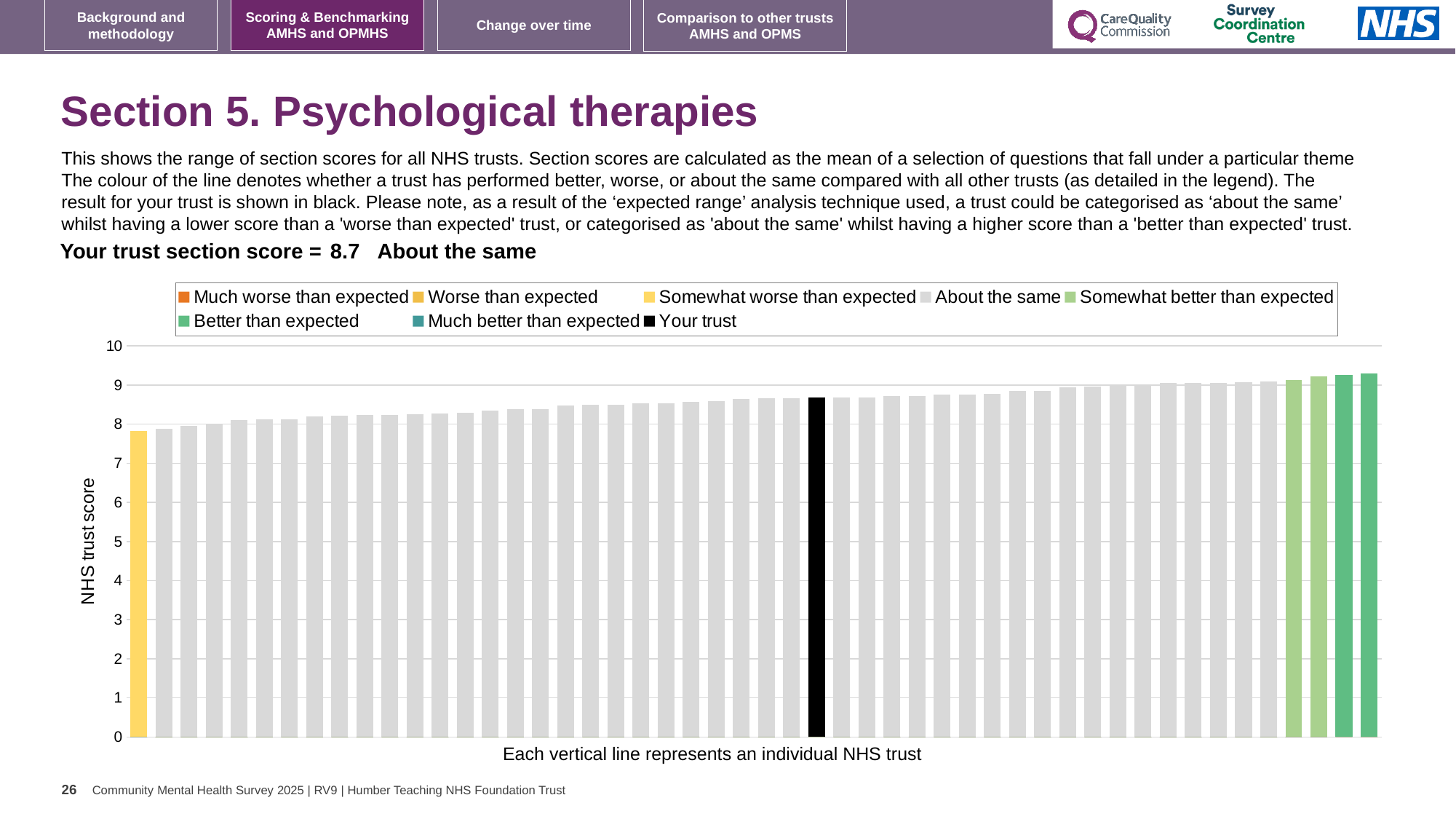
Do the bar values rise or fall from left to right across the chart? rise Is the value of the highest bar (the rightmost, green bar) greater or less than 9? greater Is the value of the lowest bar (the leftmost, yellow bar) greater or less than 8? less What colour is the bar representing your trust? black What is the label on the vertical axis of the chart? NHS trust score How many bars are coloured as 'Better than expected' (darker green)? 2 Which category is your trust's section score placed in? About the same Is the value of the black 'Your trust' bar greater or less than 8? greater What is the section score for your trust shown on the slide? 8.7 What kind of chart is shown on the slide? bar chart How many bars are coloured as 'Somewhat worse than expected' (yellow)? 1 How many entries does the chart legend list? 8